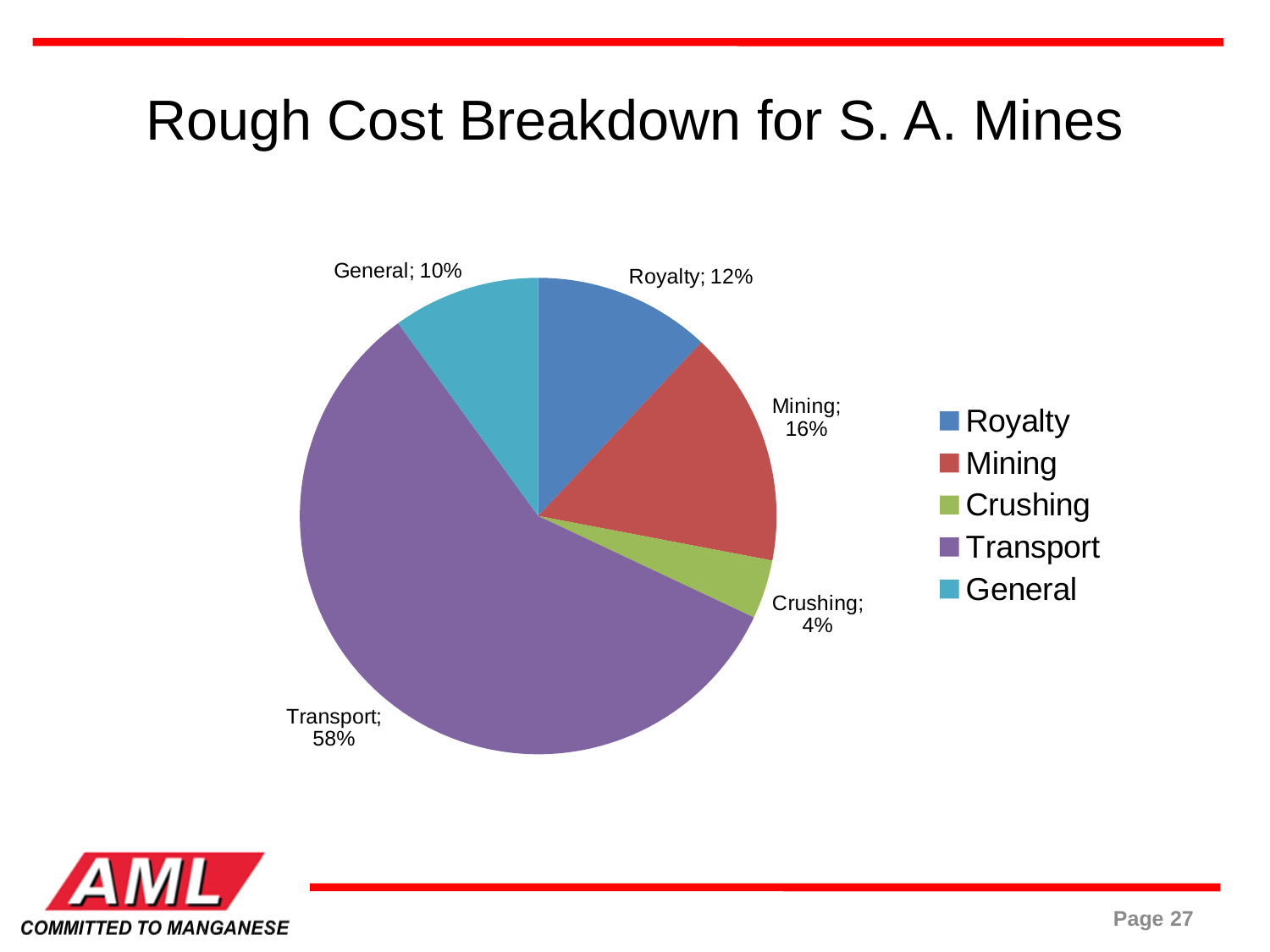
What share of the cost breakdown is General? 10% What is the difference between the Transport share and the Mining share? 42% What share of the cost breakdown is Crushing? 4% What share of the cost breakdown is Mining? 16% Which category has the smallest share of the pie? Crushing What is the title of the chart? Rough Cost Breakdown for S. A. Mines Which category has the largest share of the pie? Transport How many categories are shown in the pie chart? 5 What share of the cost breakdown is Transport? 58% What colour is the Transport slice? purple Which is larger, the Royalty share or the General share? Royalty What type of chart is shown on the slide? pie chart